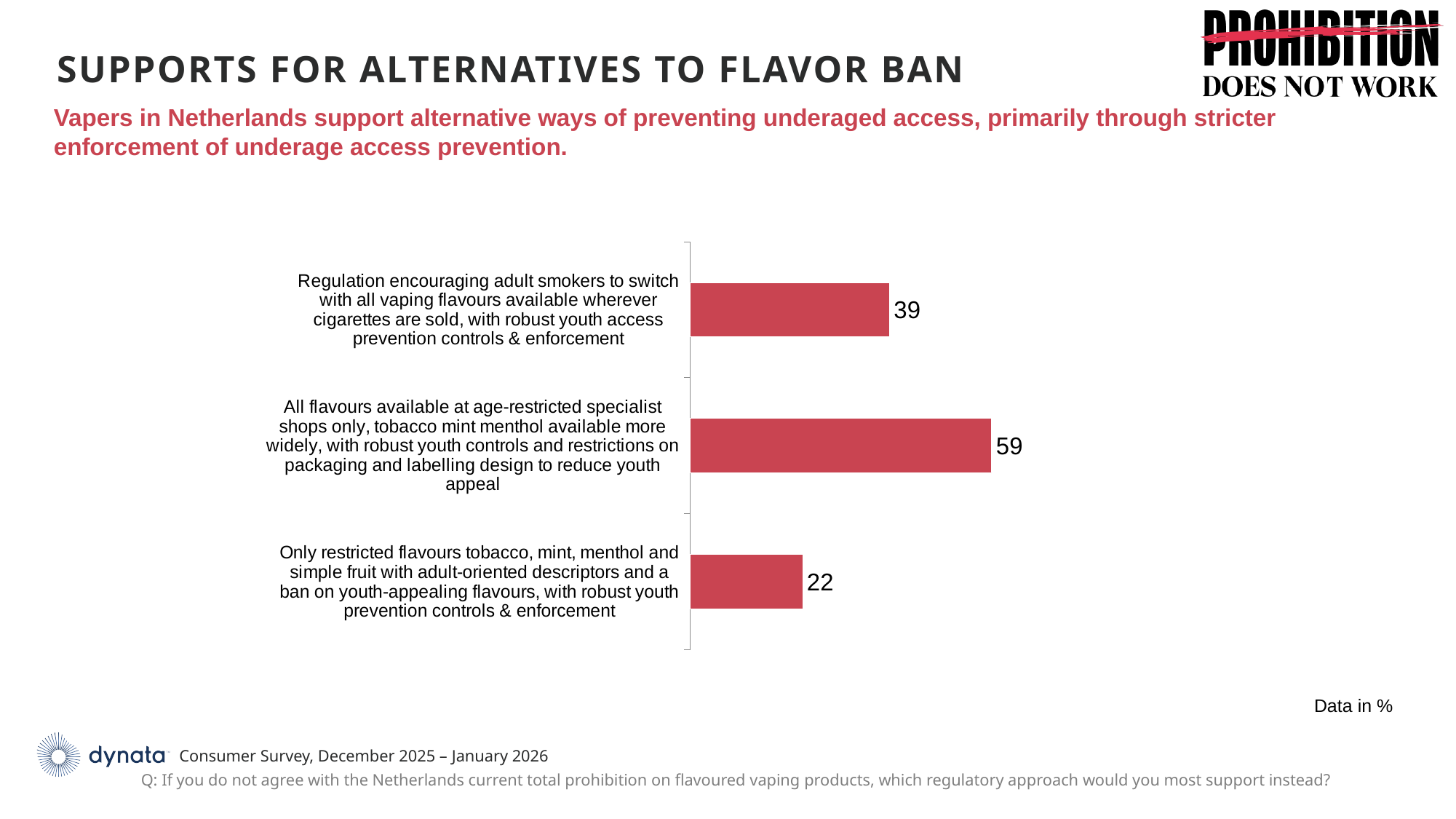
What is the difference between the highest value (59) and the lowest value (22)? 37 What colour are the bars in the chart? Red What kind of chart is shown on the slide? Bar chart What is the value for the option 'Only restricted flavours tobacco, mint, menthol and simple fruit with adult-oriented descriptors and a ban on youth-appealing flavours, with robust youth prevention controls & enforcement'? 22 How many options (bars) are shown in the chart? 3 What is the value for the option 'Regulation encouraging adult smokers to switch with all vaping flavours available wherever cigarettes are sold, with robust youth access prevention controls & enforcement'? 39 Which is larger: the value for 'Regulation encouraging adult smokers to switch...' or the value for 'All flavours available at age-restricted specialist shops only...'? All flavours available at age-restricted specialist shops only... What is the value for the option 'All flavours available at age-restricted specialist shops only, tobacco mint menthol available more widely, with robust youth controls and restrictions on packaging and labelling design to reduce youth appeal'? 59 What unit are the data values in, according to the note on the slide? % What is the difference between the value for the 'Regulation encouraging adult smokers to switch...' option and the 'Only restricted flavours...' option? 17 Which option has the lowest value? Only restricted flavours tobacco, mint, menthol and simple fruit with adult-oriented descriptors and a ban on youth-appealing flavours, with robust youth prevention controls & enforcement